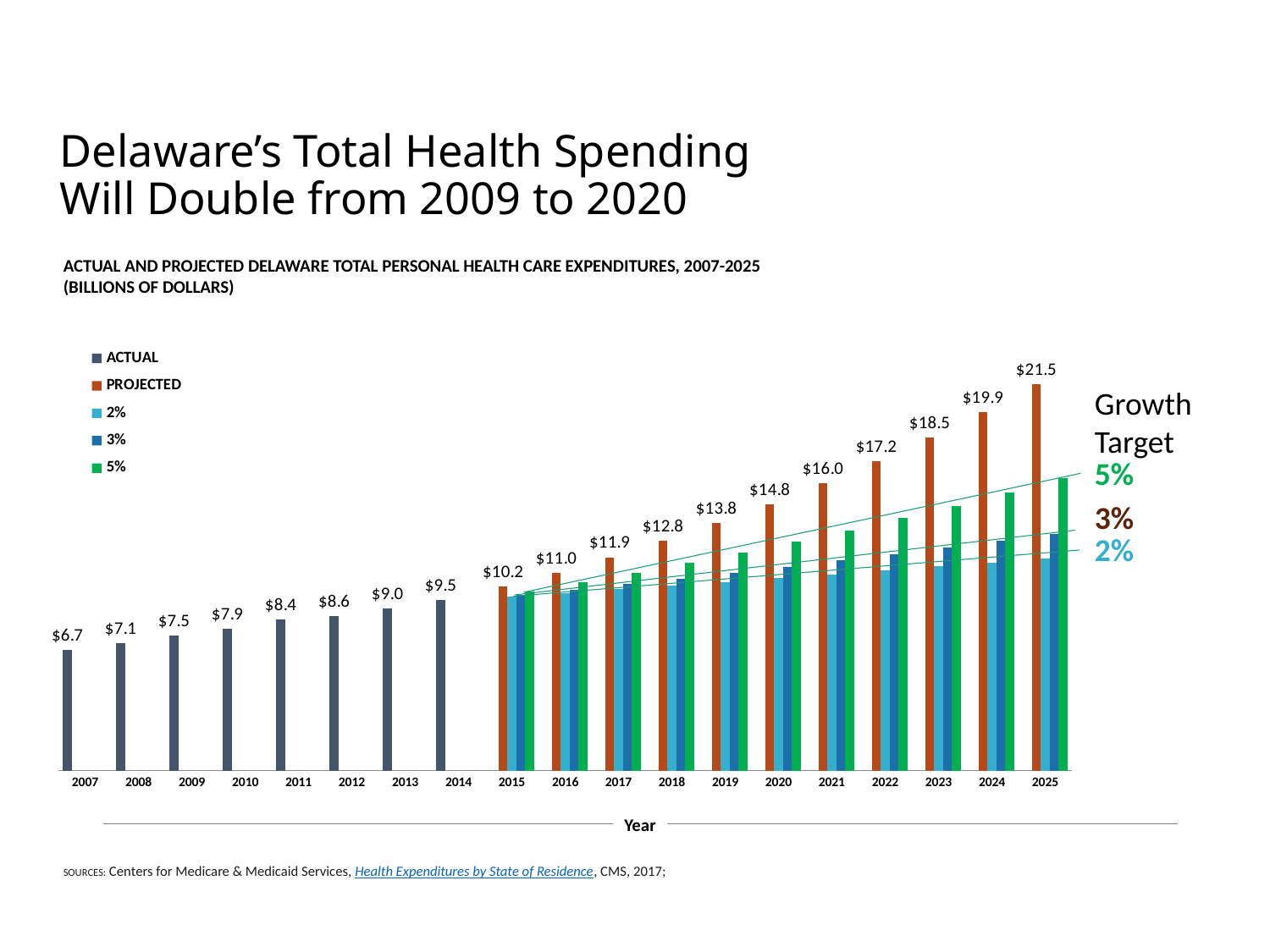
What is the projected expenditure value shown for 2025? $21.5 What kind of chart is shown on the slide? Bar chart What is the projected total personal health care expenditure for Delaware in 2020? $14.8 What is the actual total personal health care expenditure for Delaware in 2009? $7.5 Which is larger, the projected value for 2018 or the actual value for 2014? 2018 projected ($12.8) Which year has the lowest labelled expenditure value on the chart? 2007 How many series does the chart legend list? 5 How many years are shown on the x axis of the chart? 19 Do the labelled expenditure values rise or fall from 2007 to 2025? Rise What is the difference between the projected value for 2025 and the actual value for 2014? $12.0 What is the difference between the actual values for 2014 and 2007? $2.8 Which year has the highest labelled expenditure value on the chart? 2025